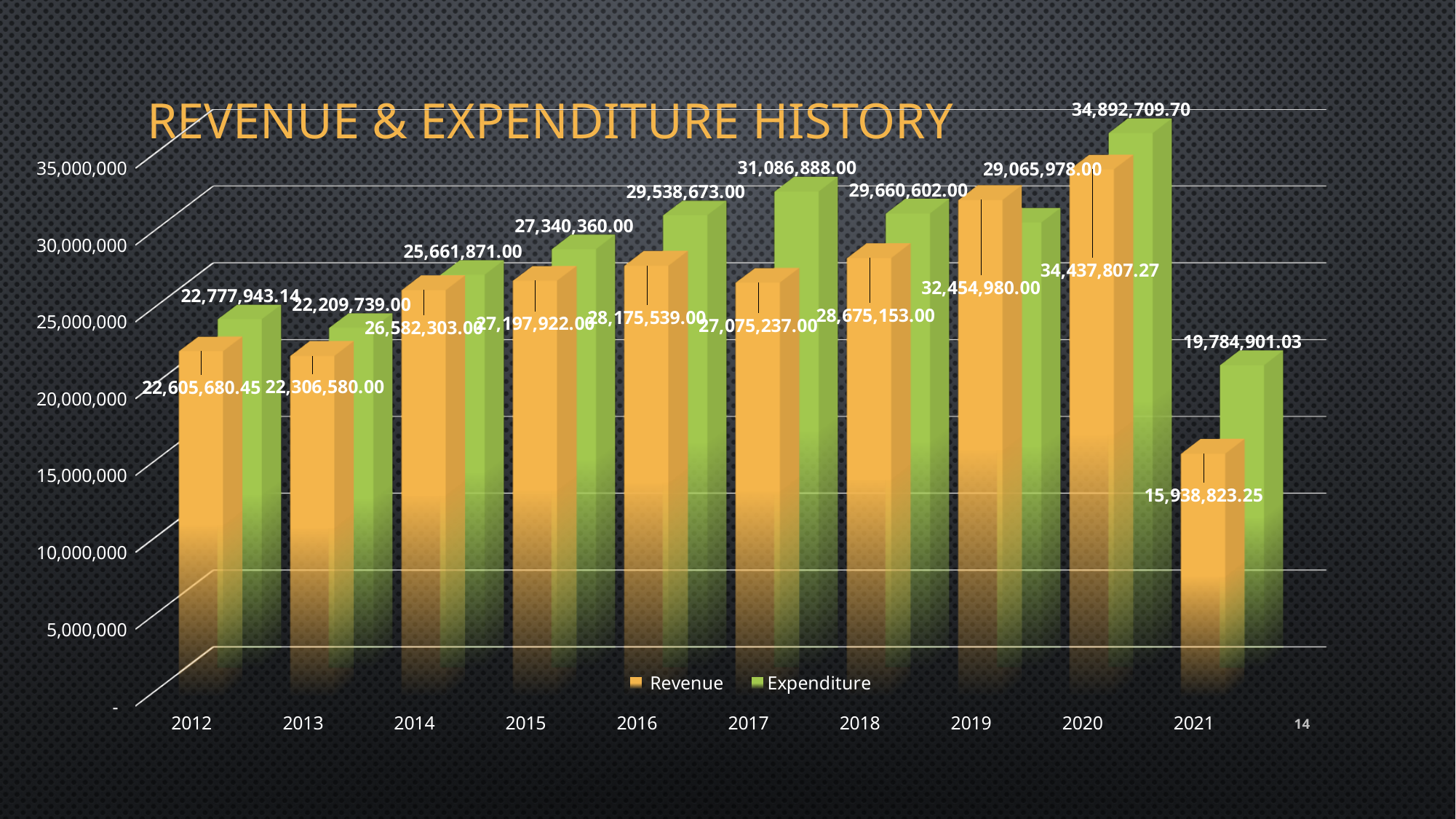
How many series does the legend list? 2 What was the Expenditure in 2017? 31,086,888.00 What kind of chart is shown on the slide? Bar chart How many years are shown on the x axis? 10 What was the Expenditure in 2020? 34,892,709.70 In which year was Revenue the lowest? 2021 By how much did Expenditure exceed Revenue in 2021? 3,846,077.78 In which year was Expenditure the highest? 2020 In 2019, which was larger, Revenue or Expenditure? Revenue What was the Revenue in 2021? 15,938,823.25 What was the Revenue in 2019? 32,454,980.00 By how much did Expenditure exceed Revenue in 2017? 4,011,651.00